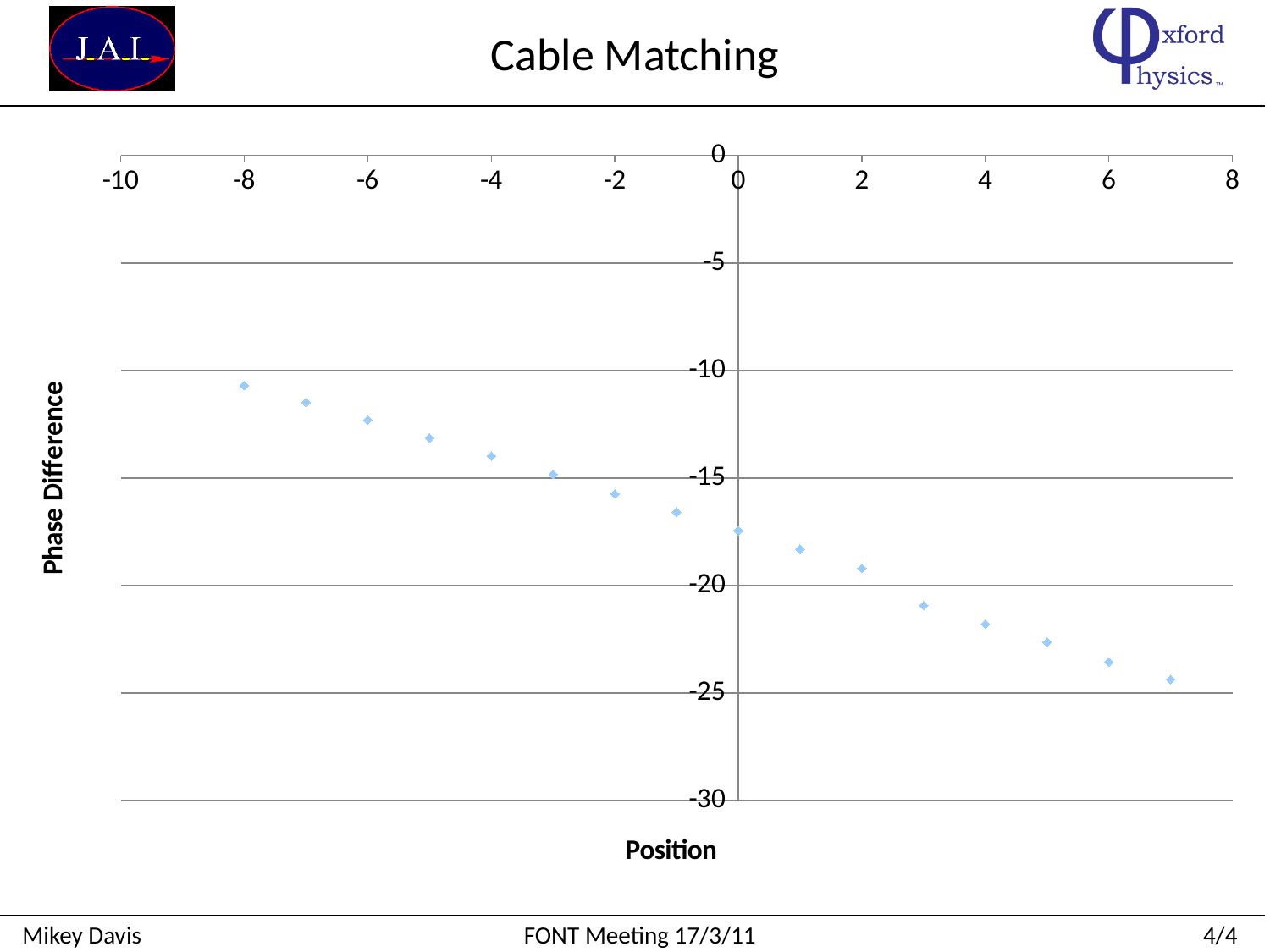
How many data points are plotted on the chart? 16 What is the title of the chart's horizontal axis? Position Is the Phase Difference value at Position 7 greater or less than -20? less What is the title of the chart's vertical axis? Phase Difference Is the Phase Difference value at Position -8 greater or less than -15? greater Do the Phase Difference values rise or fall as Position increases along the x axis? fall At which Position is the Phase Difference highest? -8 Which has the larger Phase Difference value, Position -6 or Position 4? Position -6 Is the Phase Difference value at Position 0 greater or less than -15? less What kind of chart is shown on the slide? scatter chart At which Position is the Phase Difference lowest? 7